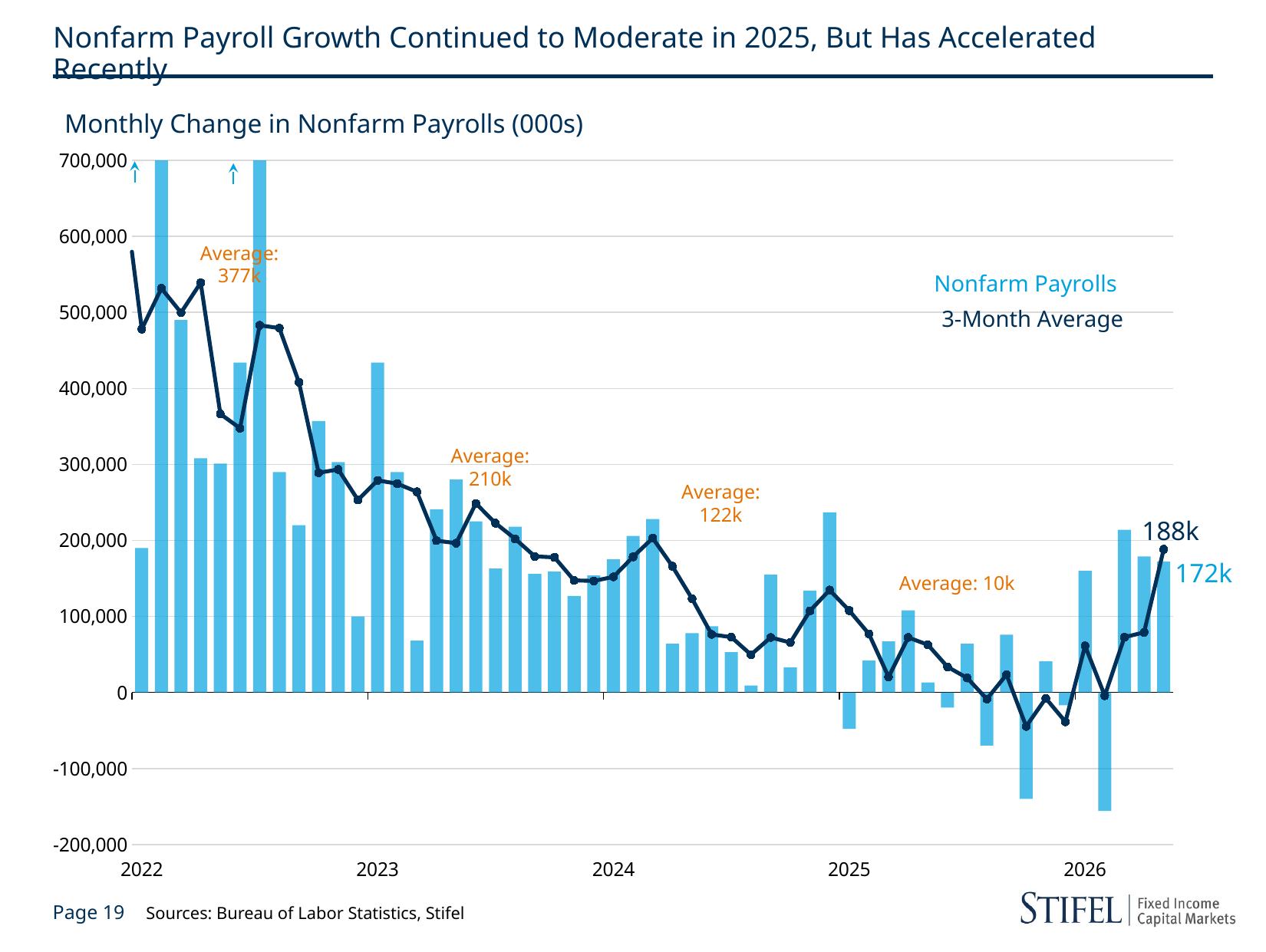
How many series does the chart's legend list? 2 Does the 3-Month Average line generally rise or fall from 2022 through 2025? fall What is the most recent 3-Month Average value labelled on the chart? 188k Which of the four annotated averages is the lowest? 10k What average is annotated for the 2022 period? 377k What average is annotated for the 2025 period? 10k What is the difference between the annotated 2022 average (377k) and the 2023 average (210k)? 167k Which is larger, the latest 3-Month Average (188k) or the latest Nonfarm Payrolls value (172k)? 3-Month Average (188k) What is the difference between the latest 3-Month Average (188k) and the latest Nonfarm Payrolls value (172k)? 16k What kind of chart is shown on the slide? A combined bar and line chart Is the lowest Nonfarm Payrolls bar in 2026 greater or less than -100,000? less What is the most recent Nonfarm Payrolls value labelled on the chart? 172k